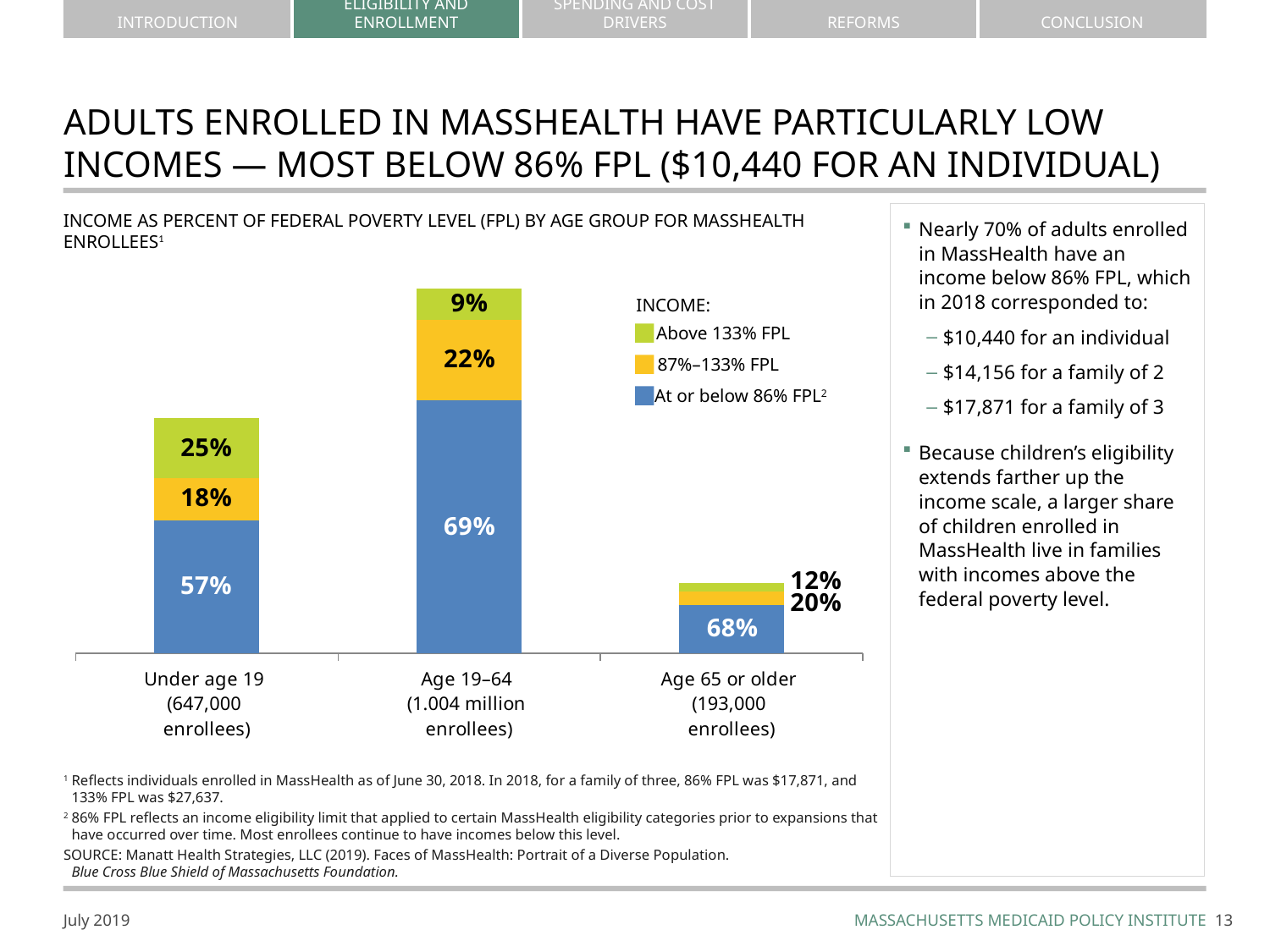
What is the difference between the share of enrollees aged 19–64 and the share of enrollees under age 19 with incomes at or below 86% FPL? 12 percentage points Which age group has the lowest share of enrollees with incomes at or below 86% FPL? Under age 19 Which is larger: the share of enrollees aged 19–64 with incomes between 87% and 133% FPL, or the share of enrollees age 65 or older in that income range? Age 19–64 How many age groups are shown on the x axis of the chart? 3 What percentage of enrollees age 65 or older have incomes at or below 86% FPL? 68% Which age group has the highest share of enrollees with incomes above 133% FPL? Under age 19 What percentage of enrollees under age 19 have incomes at or below 86% FPL? 57% What kind of chart is shown on the slide? Stacked bar chart What percentage of enrollees aged 19–64 have incomes above 133% FPL? 9% How many income categories does the chart legend list? 3 What percentage of enrollees under age 19 have incomes between 87% and 133% FPL? 18% How many enrollees are in the Age 19–64 group according to the x-axis label? 1.004 million enrollees